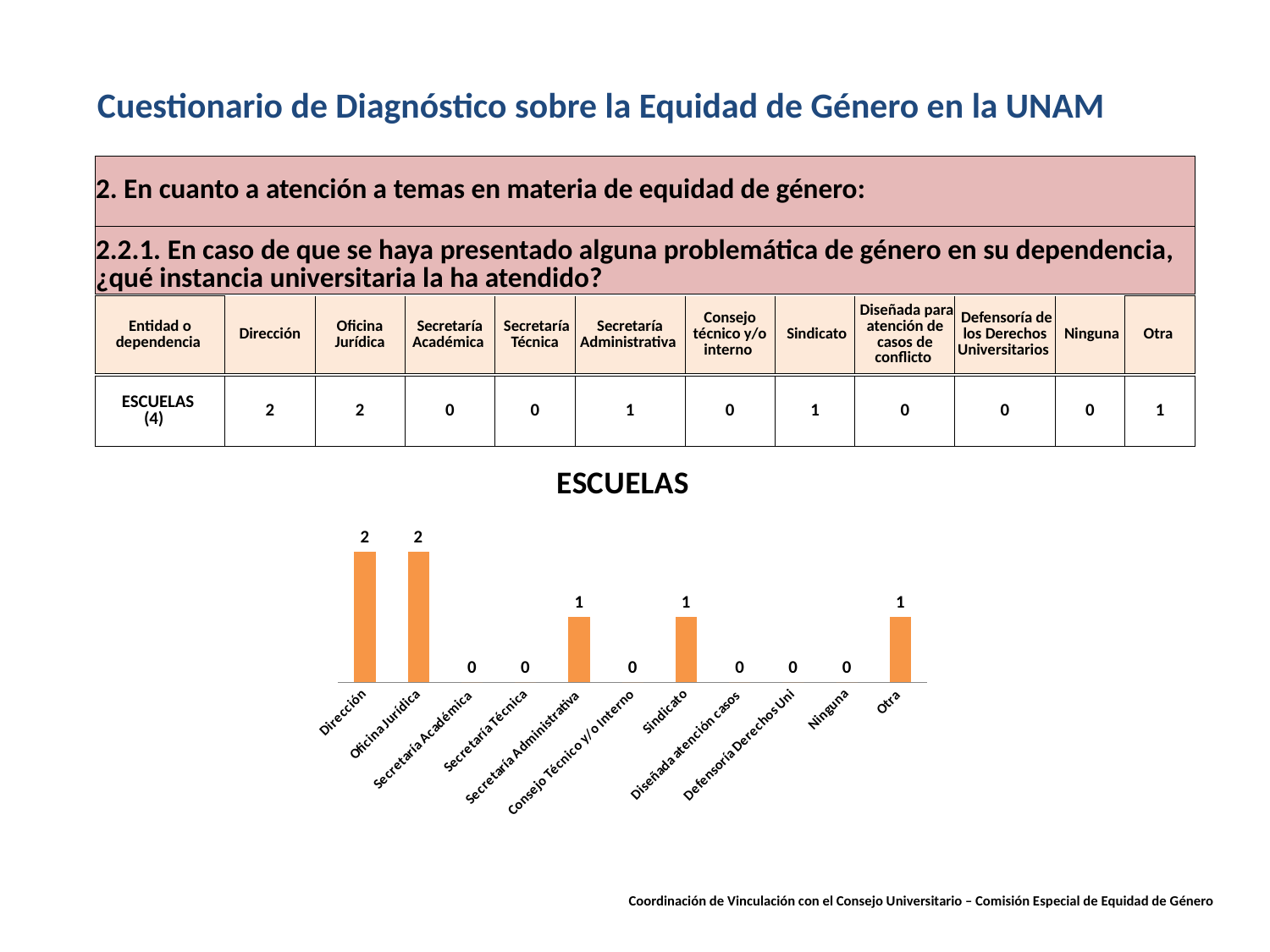
What is the value for Dirección in the ESCUELAS chart? 2 What is the value for Otra in the ESCUELAS chart? 1 Which is larger in the ESCUELAS chart, Oficina Jurídica or Secretaría Administrativa? Oficina Jurídica What is the value for Oficina Jurídica in the ESCUELAS chart? 2 What is the value for Sindicato in the ESCUELAS chart? 1 What is the difference between the values for Dirección and Sindicato in the ESCUELAS chart? 1 What kind of chart is the ESCUELAS chart? Bar chart What is the highest value shown in the ESCUELAS chart? 2 How many categories are shown on the x axis of the ESCUELAS chart? 11 What is the value for Ninguna in the ESCUELAS chart? 0 What is the title of the chart on the slide? ESCUELAS What is the value for Secretaría Administrativa in the ESCUELAS chart? 1